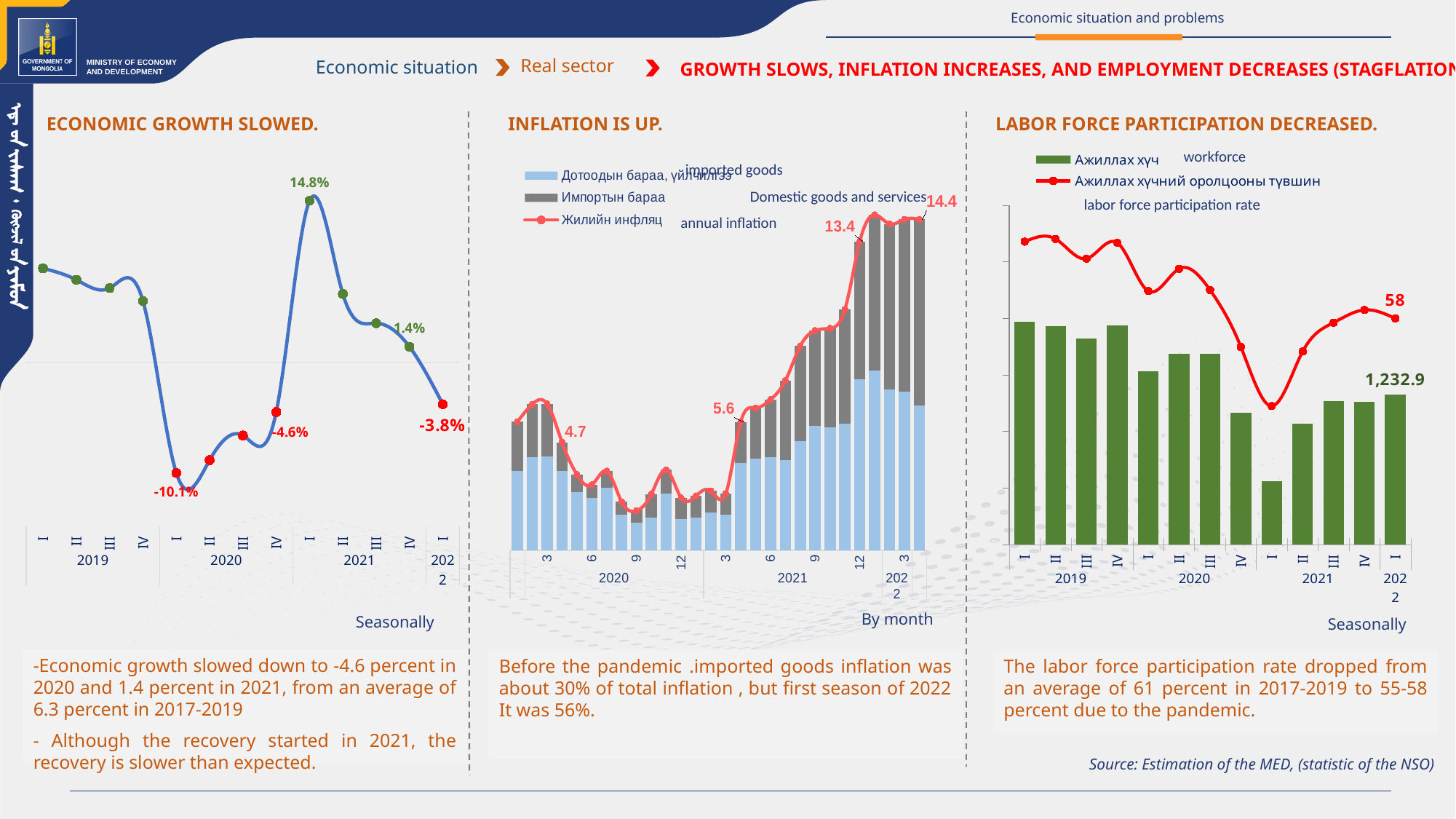
What kind of chart is the 'ECONOMIC GROWTH SLOWED.' chart? Line chart On the 'LABOR FORCE PARTICIPATION DECREASED.' chart, which quarter has the lowest workforce bar? 2021 I On the 'LABOR FORCE PARTICIPATION DECREASED.' chart, what is the labor force participation rate labelled for quarter I of 2022? 58 On the 'INFLATION IS UP.' chart, which labelled annual inflation value is larger: 4.7 or 5.6? 5.6 On the 'ECONOMIC GROWTH SLOWED.' chart, which quarter has the lowest value? 2020 I (-10.1%) On the 'ECONOMIC GROWTH SLOWED.' chart, what is the difference between the highest labelled value (14.8%) and the lowest labelled value (-10.1%)? 24.9 percentage points On the 'ECONOMIC GROWTH SLOWED.' chart, what is the growth value labelled for quarter I of 2021? 14.8% On the 'ECONOMIC GROWTH SLOWED.' chart, what is the value labelled for quarter I of 2022? -3.8% How many series does the legend of the 'INFLATION IS UP.' chart list? 3 On the 'INFLATION IS UP.' chart, what is the annual inflation value labelled for March 2022? 14.4 On the 'LABOR FORCE PARTICIPATION DECREASED.' chart, what is the workforce value labelled for quarter I of 2022? 1,232.9 On the 'ECONOMIC GROWTH SLOWED.' chart, do the values rise or fall from quarter I of 2021 to quarter I of 2022? Fall